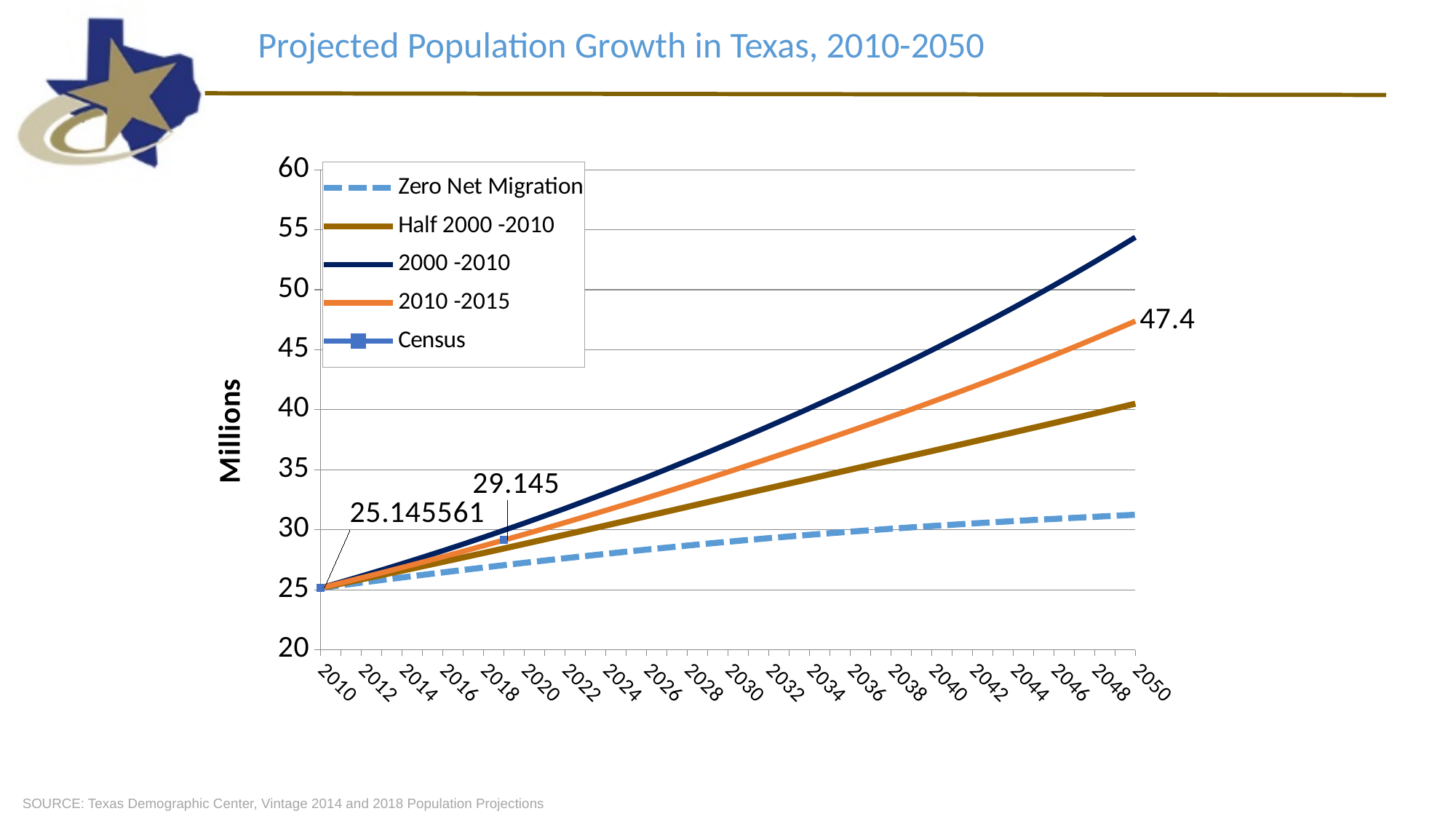
Is the value of the Zero Net Migration series in 2050 greater or less than 35? less What value is labelled at the end of the 2010 -2015 line in 2050? 47.4 What is the Census value labelled for 2010? 25.145561 Do the projection lines rise or fall from 2010 to 2050? rise Which series has the highest value in 2050? 2000 -2010 Which series has the lowest value in 2050? Zero Net Migration Which is larger in 2050, the 2000 -2010 series or the 2010 -2015 series? 2000 -2010 What is the label on the vertical axis? Millions How many series does the legend list? 5 What kind of chart is shown on the slide? line chart Is the value of the 2000 -2010 series in 2050 greater or less than 50? greater